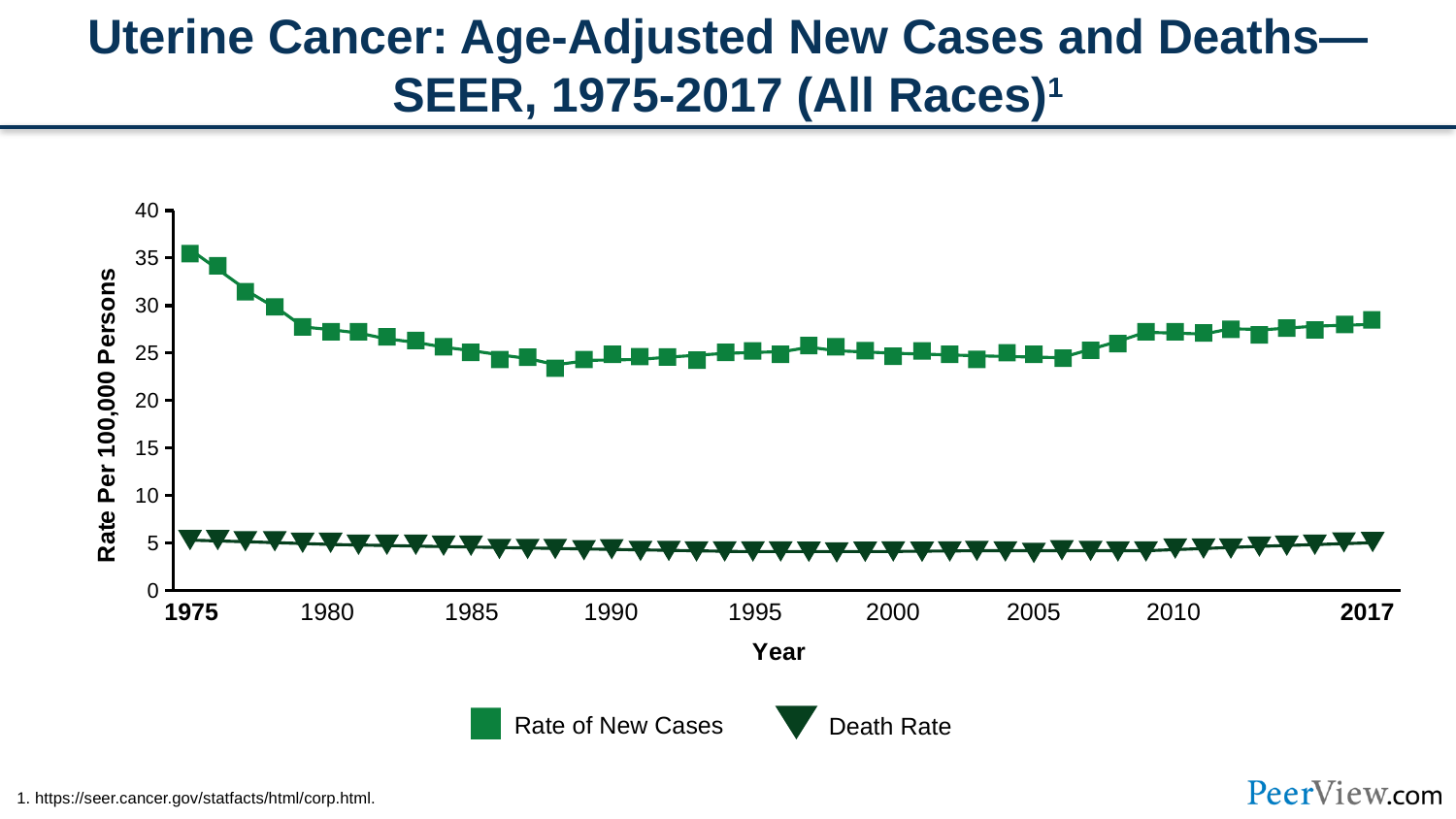
Is the Death Rate in 2017 greater or less than 10? less Is the Rate of New Cases in 1975 greater or less than 30? greater What are the two series named in the legend? Rate of New Cases and Death Rate How many series does the legend list? 2 What is the label of the y axis? Rate Per 100,000 Persons What kind of chart is shown on the slide? Line chart In which year is the Rate of New Cases highest? 1975 In 2000, which series has the higher value, Rate of New Cases or Death Rate? Rate of New Cases Is the Rate of New Cases in 1990 greater or less than 30? less Does the Rate of New Cases rise or fall between 1975 and 1988? Fall Which is larger, the Rate of New Cases in 1975 or in 2017? 1975